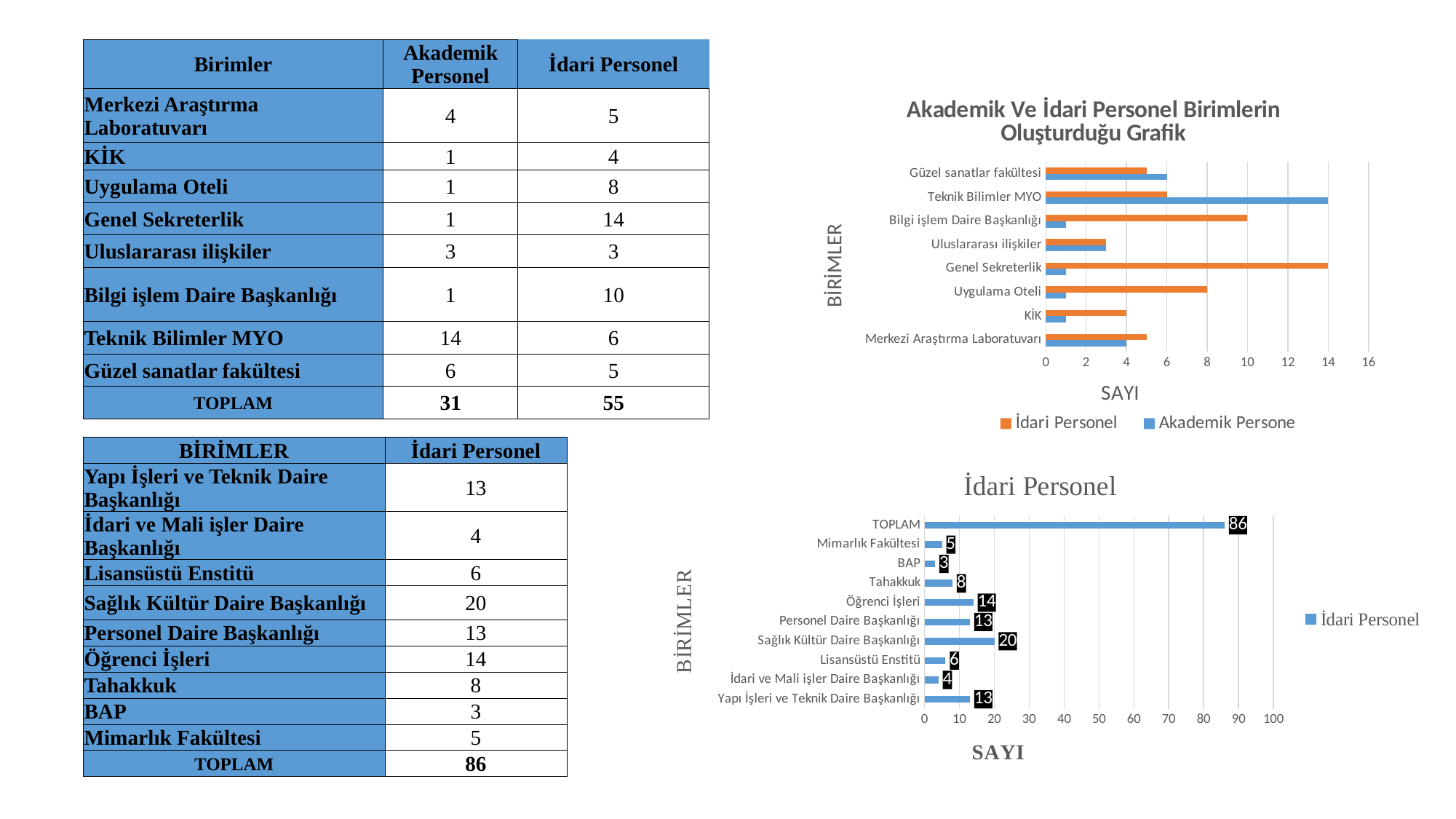
In the chart titled 'Akademik Ve İdari Personel Birimlerin Oluşturduğu Grafik', which category has the highest İdari Personel value? Genel Sekreterlik In the chart titled 'İdari Personel', how many categories are shown on the y axis? 10 In the chart titled 'İdari Personel', what is the value for Sağlık Kültür Daire Başkanlığı? 20 What kind of chart is the chart titled 'Akademik Ve İdari Personel Birimlerin Oluşturduğu Grafik'? bar chart In the chart titled 'Akademik Ve İdari Personel Birimlerin Oluşturduğu Grafik', how many series does the legend list? 2 In the chart titled 'Akademik Ve İdari Personel Birimlerin Oluşturduğu Grafik', what is the label of the x axis? SAYI In the chart titled 'İdari Personel', what is the value for TOPLAM? 86 In the chart titled 'İdari Personel', which is larger: Lisansüstü Enstitü or Mimarlık Fakültesi? Lisansüstü Enstitü In the chart titled 'İdari Personel', which category other than TOPLAM has the lowest value? BAP In the chart titled 'Akademik Ve İdari Personel Birimlerin Oluşturduğu Grafik', which category has the highest Akademik Personel value? Teknik Bilimler MYO In the chart titled 'Akademik Ve İdari Personel Birimlerin Oluşturduğu Grafik', is the İdari Personel value for Uluslararası ilişkiler greater or less than 4? less In the chart titled 'İdari Personel', what is the difference between Öğrenci İşleri and Tahakkuk? 6